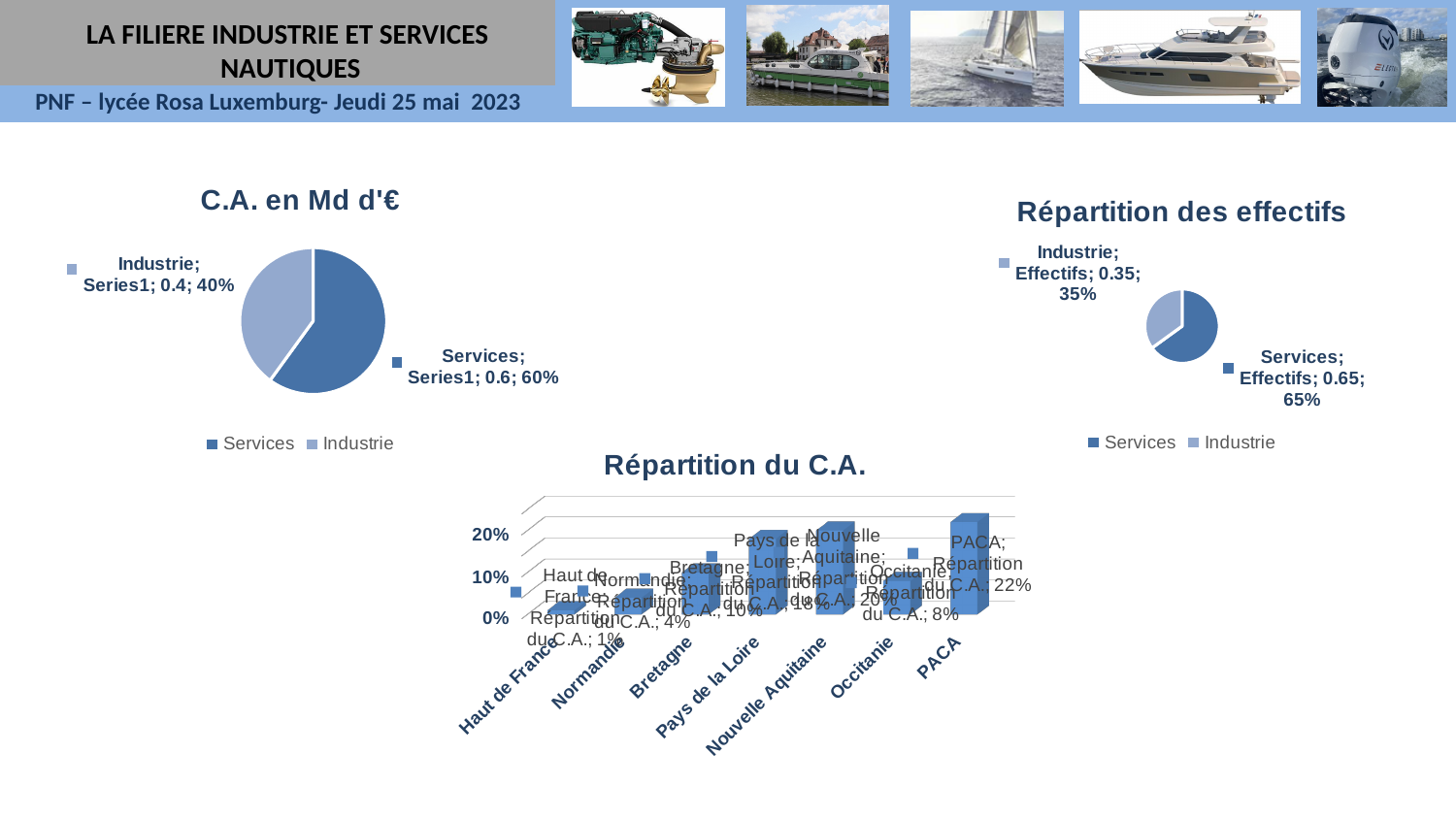
In the chart titled "C.A. en Md d'€", what value is shown for Industrie? 0.4 In the chart titled "Répartition du C.A.", what is the difference between the values for Bretagne and Normandie? 6% In the chart titled "Répartition des effectifs", which slice is larger, Services or Industrie? Services In the chart titled "Répartition du C.A.", which region has the highest value? PACA In the chart titled "Répartition du C.A.", what is the value for Haut de France? 1% In the chart titled "Répartition du C.A.", what is the value for PACA? 22% In the chart titled "C.A. en Md d'€", what percentage share does Services have? 60% In the chart titled "Répartition des effectifs", what value is shown for Services? 0.65 In the chart titled "Répartition des effectifs", what percentage share does Industrie have? 35% What kind of chart is "C.A. en Md d'€"? Pie chart How many entries does the legend of the chart titled "Répartition des effectifs" list? 2 How many regions are shown in the chart titled "Répartition du C.A."? 7